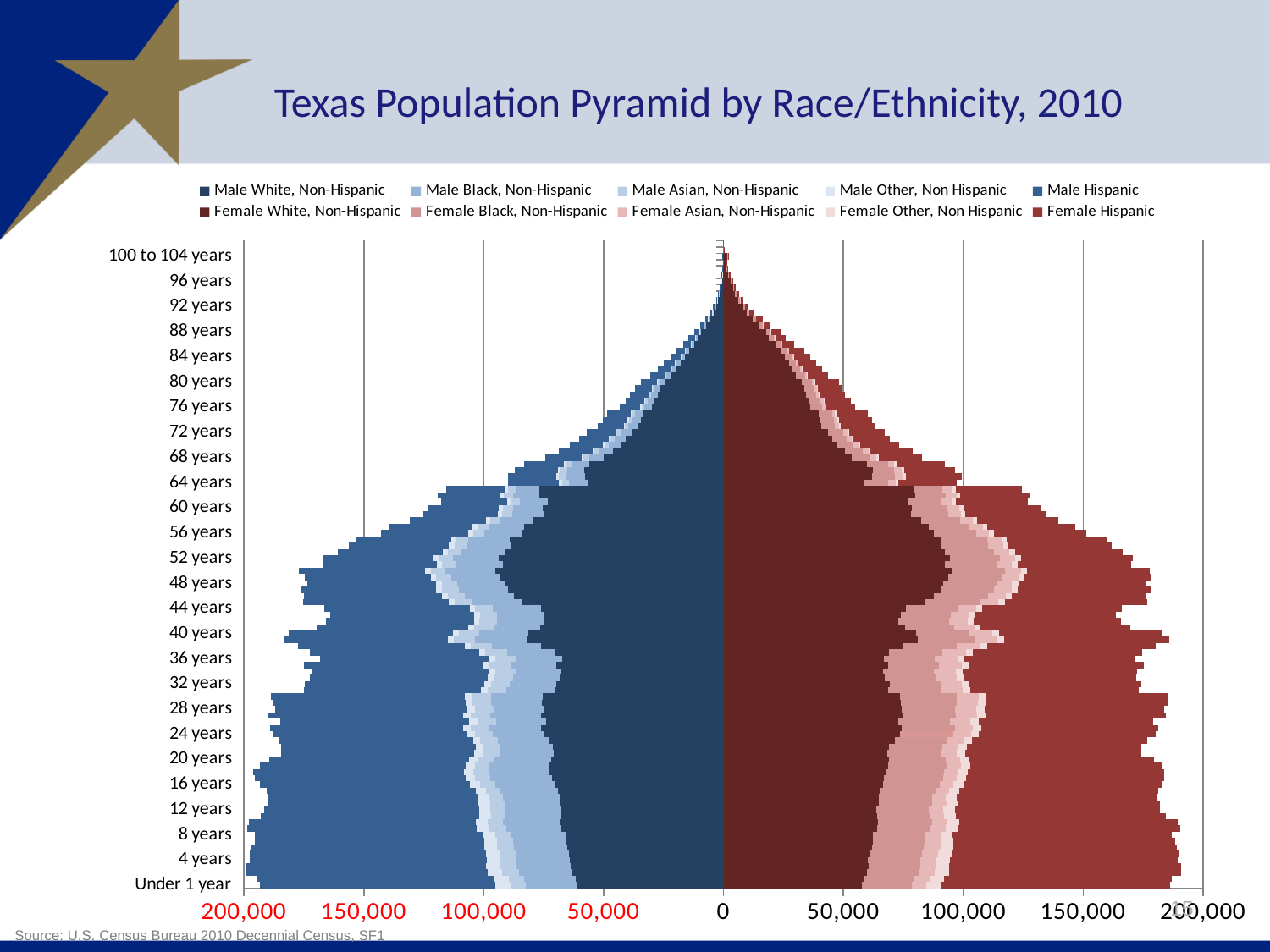
How many series does the legend list? 10 At 80 years, which total is larger, male or female? Female Is the total female population for 84 years greater or less than 50,000? less Which side of the pyramid shows the female series, the left or the right? Right Is the total male population for 60 years greater or less than 100,000? greater Is the total male population for 84 years greater or less than 50,000? less What is the title of the chart? Texas Population Pyramid by Race/Ethnicity, 2010 Do the total bar lengths generally increase or decrease as age rises from Under 1 year to 100 to 104 years? Decrease What kind of chart is shown on the slide? Bar chart (population pyramid)